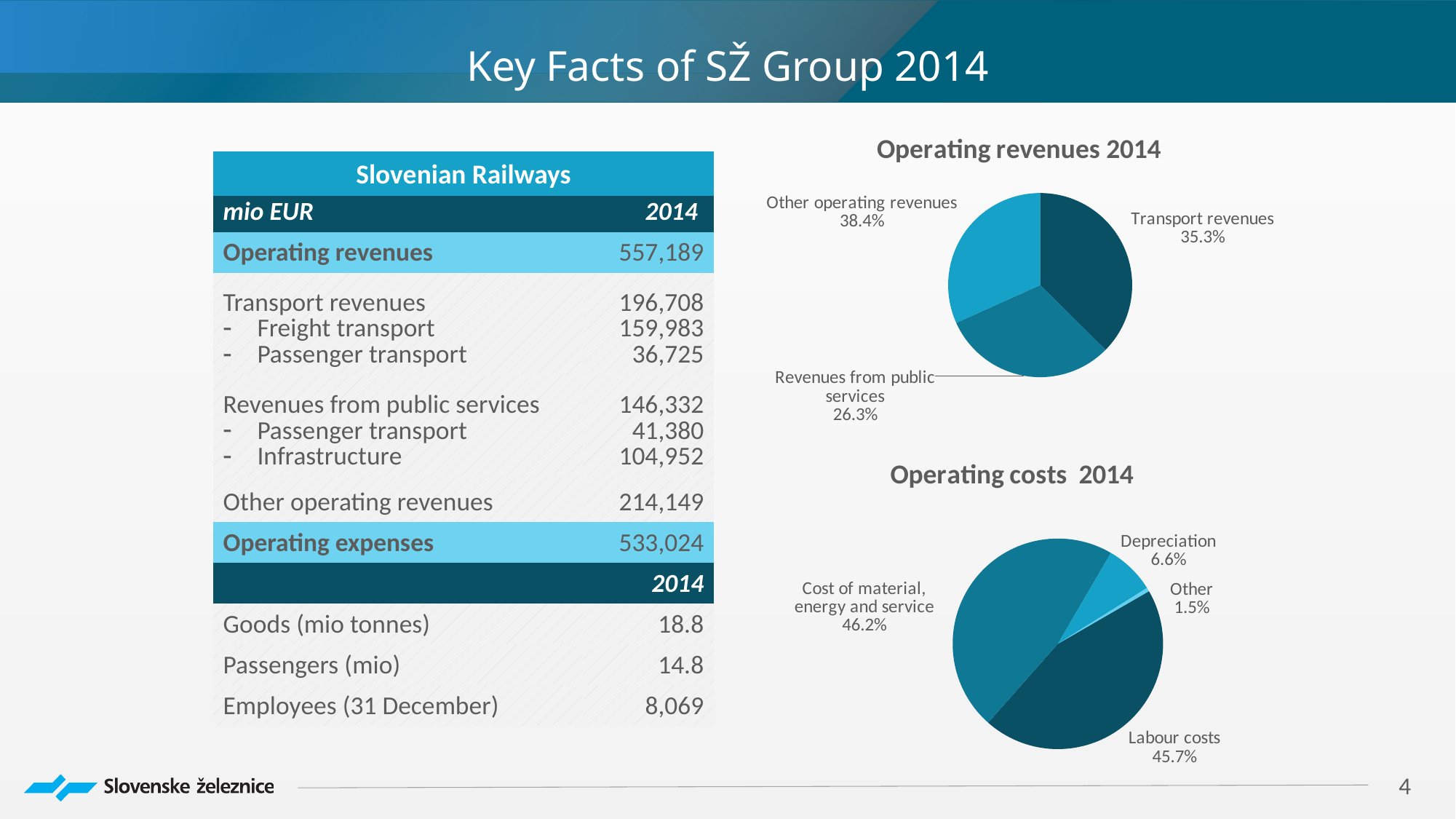
In the Operating costs 2014 chart, which category has the smallest share? Other In the Operating revenues 2014 chart, how many slices does the pie have? 3 In the Operating costs 2014 chart, how many categories are shown? 4 In the Operating costs 2014 chart, what share do Labour costs have? 45.7% What type of chart is the Operating costs 2014 chart? Pie chart In the Operating revenues 2014 chart, what is the difference in percentage points between Other operating revenues and Transport revenues? 3.1 In the Operating revenues 2014 chart, which category has the smallest share? Revenues from public services In the Operating revenues 2014 chart, what share do Revenues from public services have? 26.3% In the Operating costs 2014 chart, which is larger: Cost of material, energy and service or Labour costs? Cost of material, energy and service In the Operating revenues 2014 chart, which category has the largest share? Other operating revenues In the Operating costs 2014 chart, what share does Depreciation have? 6.6%